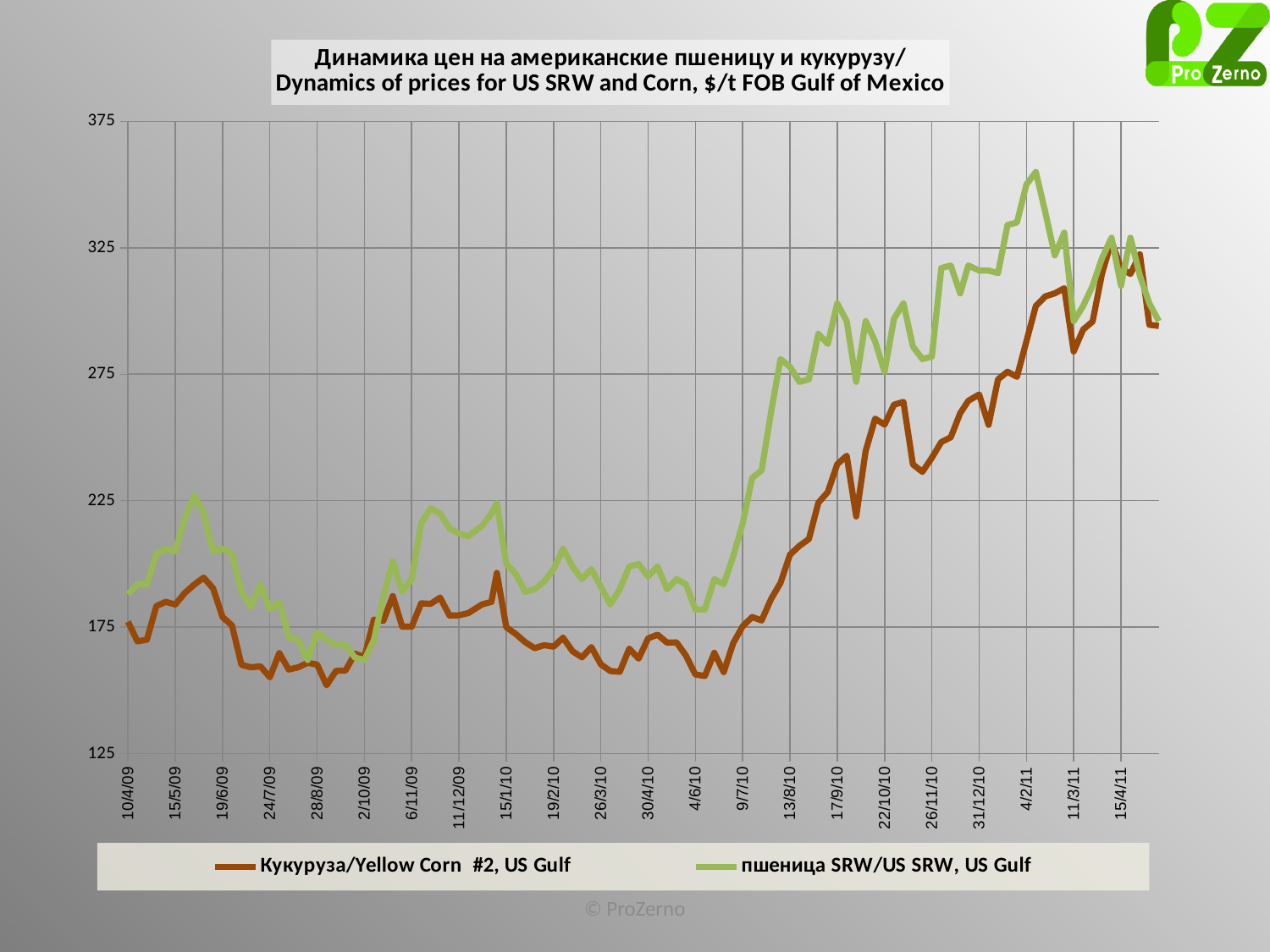
Is the value for пшеница SRW/US SRW at 4/2/11 greater or less than 325? greater What kind of chart is shown on the slide? line chart How many series does the legend list? 2 Is the value for Кукуруза/Yellow Corn at 4/6/10 greater or less than 175? less Which series reaches the highest value anywhere on the chart? пшеница SRW/US SRW, US Gulf Does the пшеница SRW/US SRW line rise or fall between 15/1/10 and 4/6/10? fall Is the value for Кукуруза/Yellow Corn at 22/10/10 greater or less than 275? less What is the highest value shown on the vertical axis? 375 Which series is shown by the green line? пшеница SRW/US SRW, US Gulf At 4/2/11, which series has the higher value, Кукуруза/Yellow Corn or пшеница SRW/US SRW? пшеница SRW/US SRW Does the Кукуруза/Yellow Corn line rise or fall between 9/7/10 and 4/2/11? rise